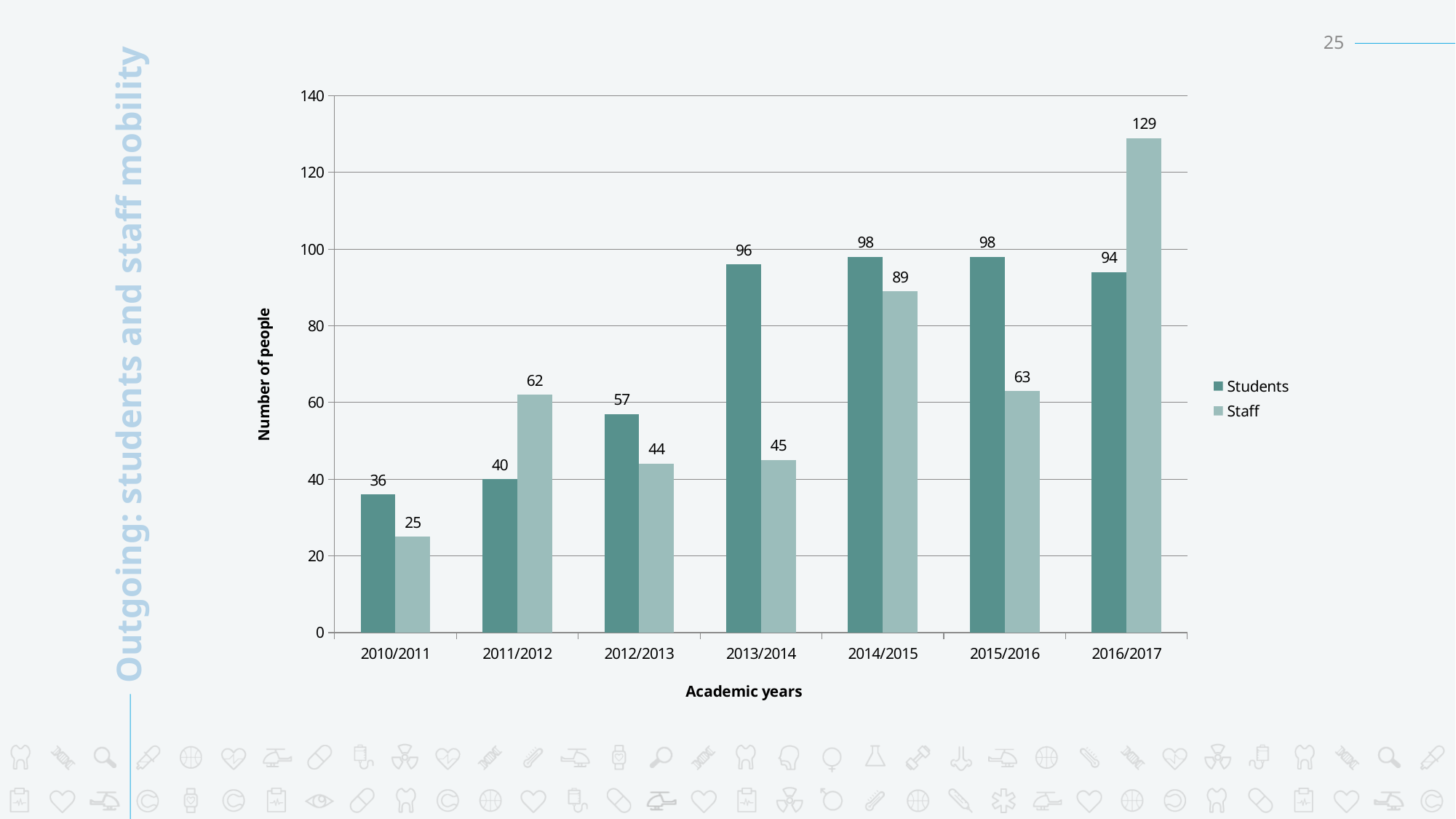
Is the Staff value for 2014/2015 greater or less than 80? greater What kind of chart is shown on the slide? Bar chart What is the label of the y axis? Number of people What is the number of Staff for 2010/2011? 25 Which academic year has the highest Staff value? 2016/2017 What is the number of Staff for 2016/2017? 129 Which academic year has the lowest Students value? 2010/2011 Which is larger in 2011/2012, Students or Staff? Staff How many series does the legend list? 2 How many academic years are shown on the x axis? 7 What is the difference between Staff and Students in 2016/2017? 35 What is the number of Students for 2013/2014? 96